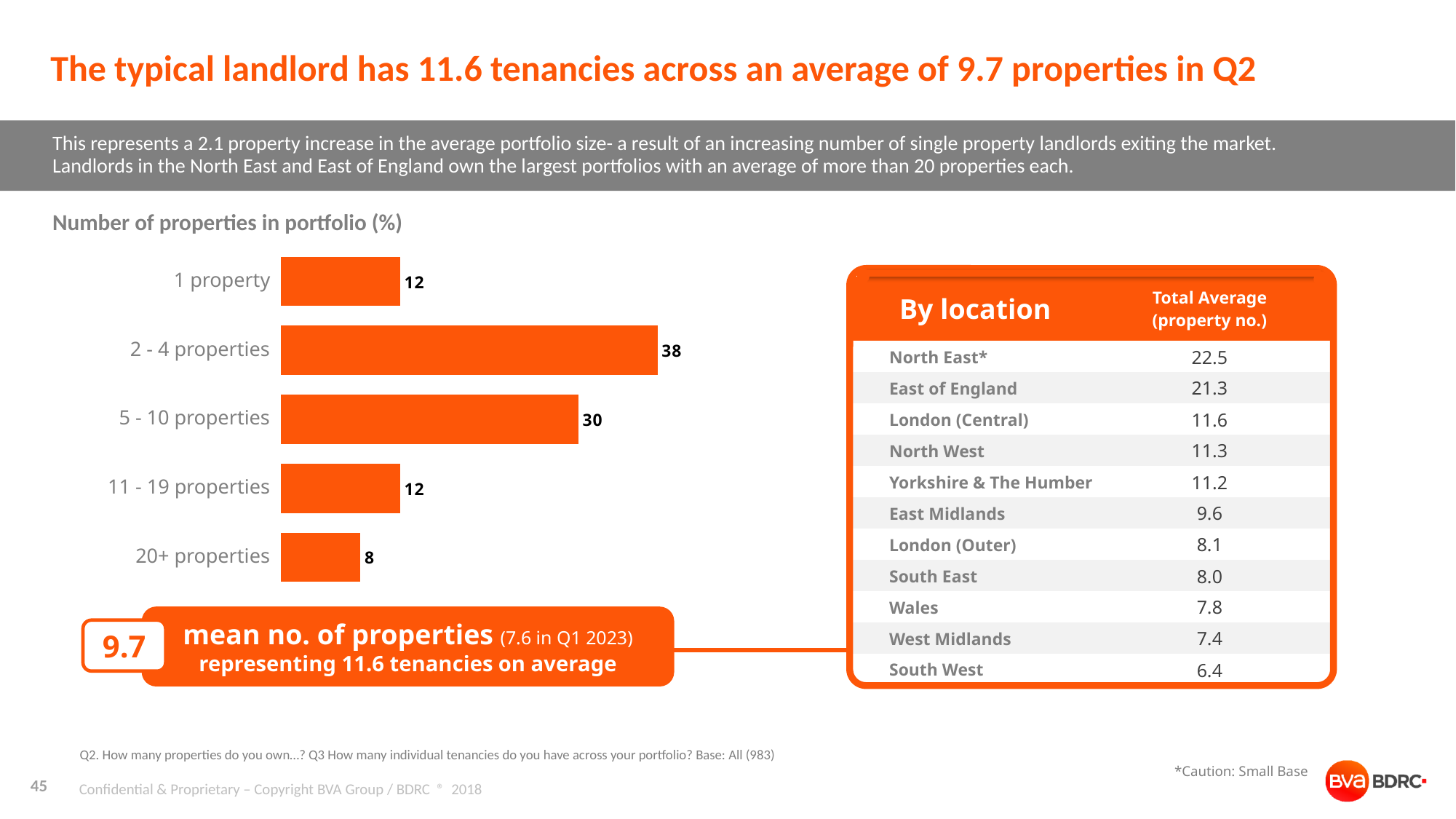
What is the difference between the values for '2 - 4 properties' and '5 - 10 properties' in the 'Number of properties in portfolio (%)' chart? 8 What colour are the bars in the 'Number of properties in portfolio (%)' chart? Orange Which category has the lowest value in the 'Number of properties in portfolio (%)' chart? 20+ properties How many categories are shown in the 'Number of properties in portfolio (%)' chart? 5 What is the value for '5 - 10 properties' in the 'Number of properties in portfolio (%)' chart? 30 What is the difference between the values for '1 property' and '20+ properties' in the 'Number of properties in portfolio (%)' chart? 4 What is the value for '2 - 4 properties' in the 'Number of properties in portfolio (%)' chart? 38 In the 'Number of properties in portfolio (%)' chart, which is larger: the value for '5 - 10 properties' or '11 - 19 properties'? 5 - 10 properties Which category has the highest value in the 'Number of properties in portfolio (%)' chart? 2 - 4 properties What is the value for '20+ properties' in the 'Number of properties in portfolio (%)' chart? 8 What kind of chart is the 'Number of properties in portfolio (%)' chart? Bar chart Do the values for '1 property' and '11 - 19 properties' in the 'Number of properties in portfolio (%)' chart have the same value? Yes, both are 12